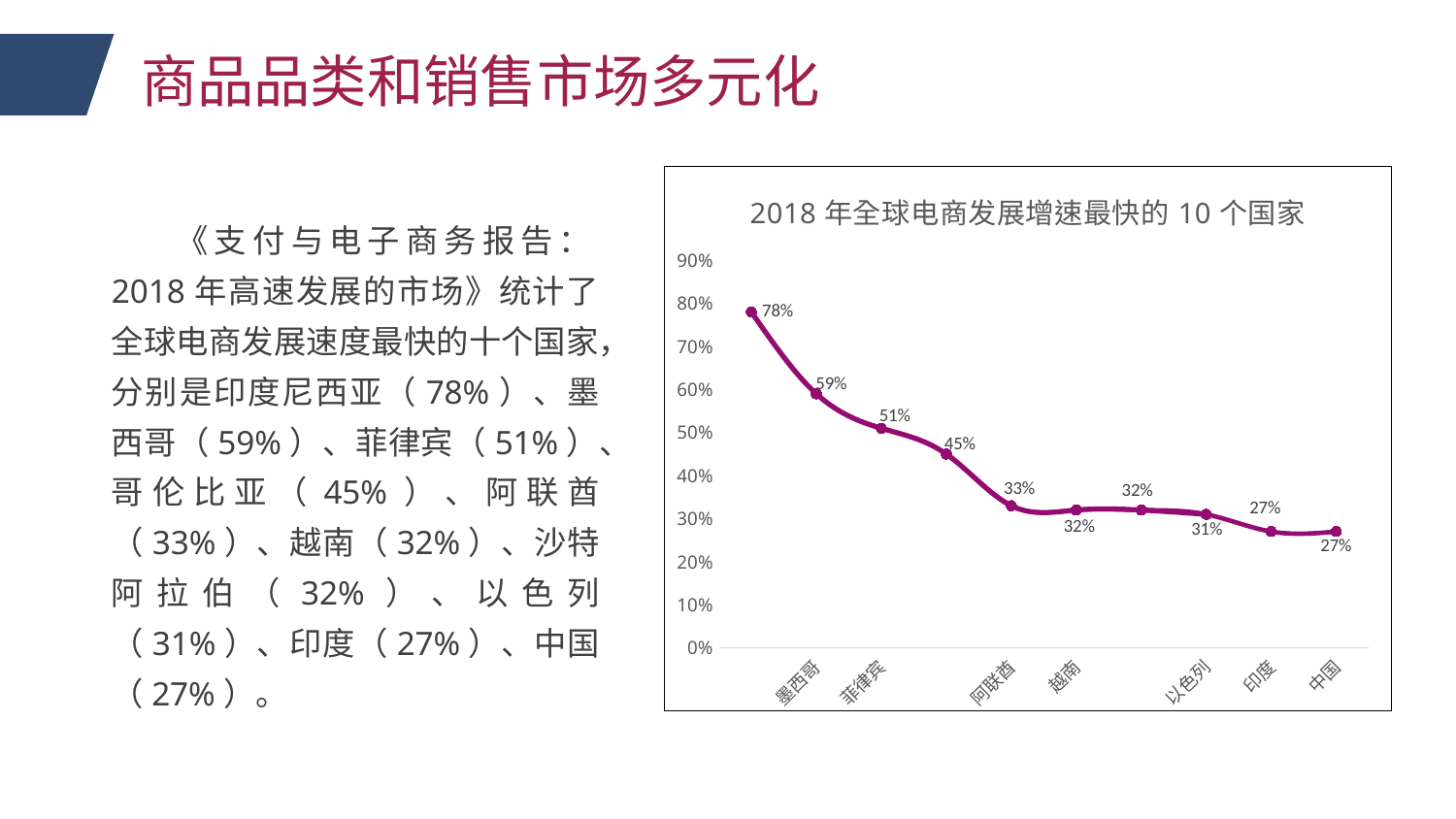
What is the value plotted for 阿联酋? 33% What is the value plotted for 菲律宾? 51% What is the title of the chart? 2018 年全球电商发展增速最快的 10 个国家 What is the value plotted for 印度? 27% What is the highest value plotted on the chart? 78% What is the value plotted for 墨西哥? 59% Do the values rise or fall moving from left to right along the x axis? fall How many data points are plotted on the line? 10 What is the difference between the values for 墨西哥 and 菲律宾? 8% What is the value plotted for 以色列? 31% What type of chart is shown on the slide? line chart What is the lowest value plotted on the chart? 27%